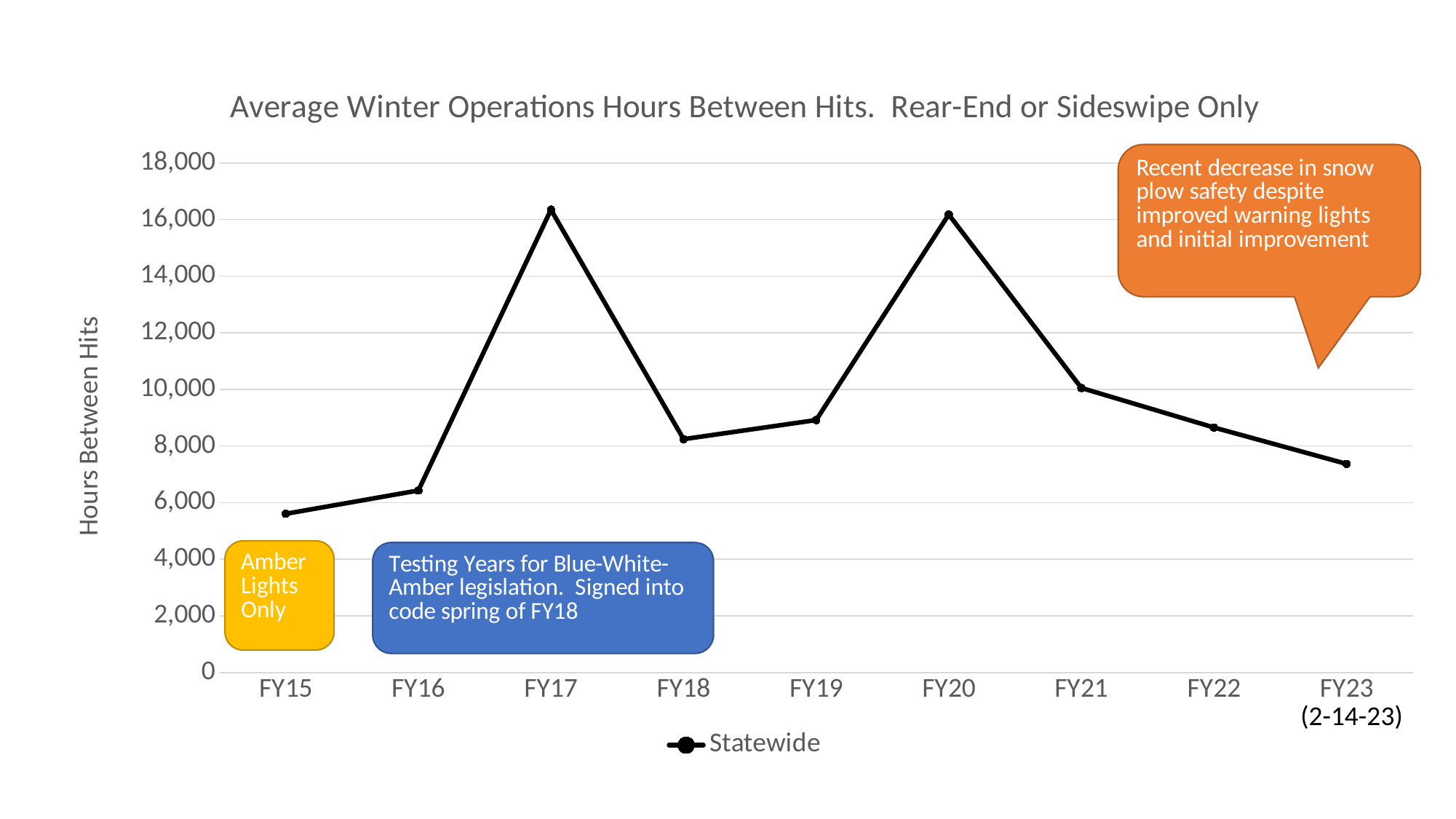
What is the name of the series shown in the legend? Statewide Which has more hours between hits, FY18 or FY19? FY19 How many fiscal years are plotted on the x axis? 9 Is the value for FY17 greater or less than 16,000? greater What kind of chart is shown on the slide? line chart Is the value for FY20 greater or less than 14,000? greater Do the values rise or fall from FY20 to FY23? fall Is the value for FY23 greater or less than 8,000? less How many series does the legend list? 1 Which fiscal year has the lowest hours between hits? FY15 Which has more hours between hits, FY21 or FY22? FY21